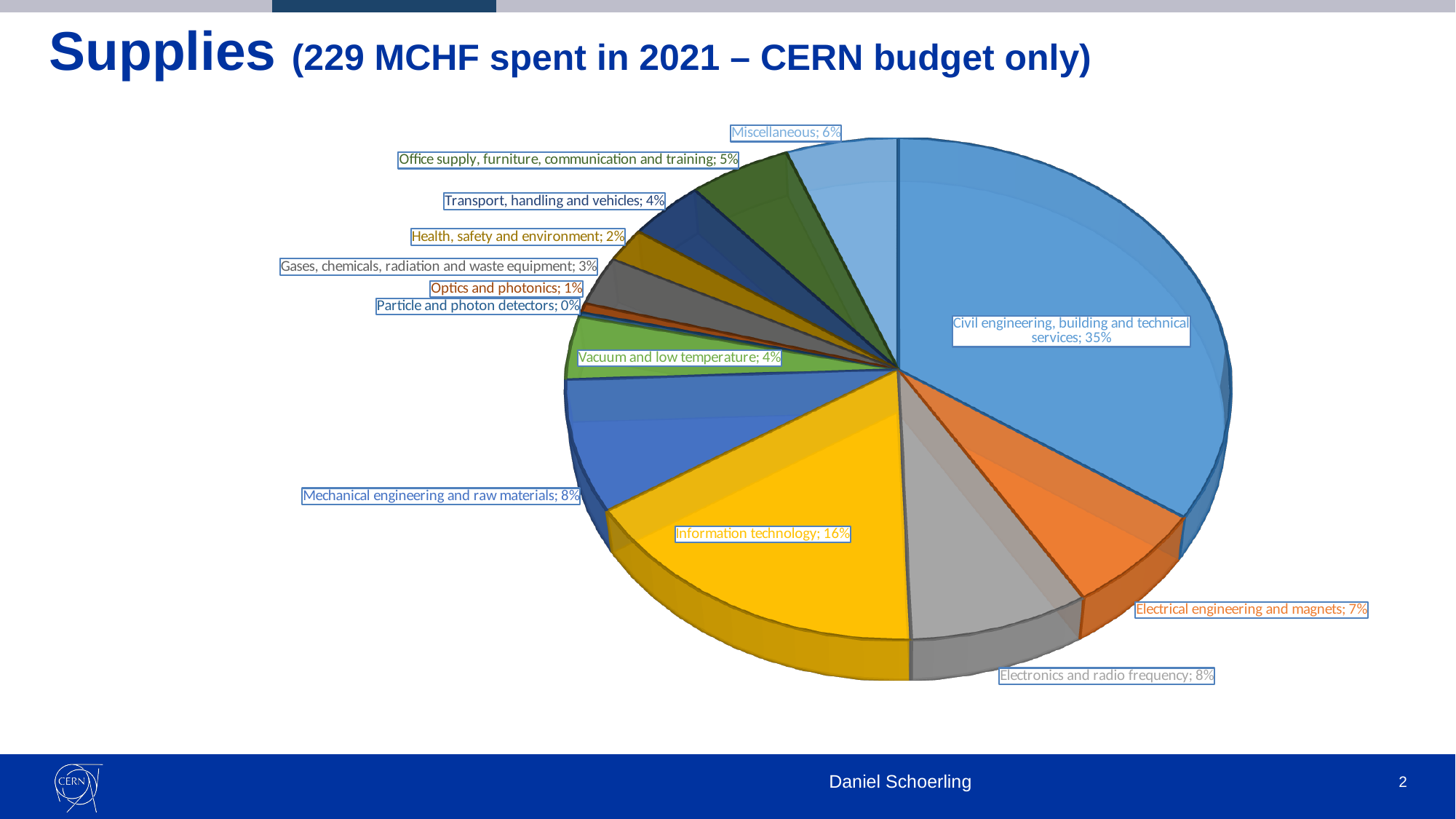
Which is larger, the share for Office supply, furniture, communication and training or the share for Transport, handling and vehicles? Office supply, furniture, communication and training What kind of chart is shown on the slide? pie chart What share of supplies spending goes to Information technology? 16% What percentage is shown for Electrical engineering and magnets? 7% How many categories are shown in the pie chart? 13 Which category has the smallest share of the pie? Particle and photon detectors What percentage is shown for Miscellaneous? 6% What percentage is shown for Gases, chemicals, radiation and waste equipment? 3% What share of supplies spending goes to Civil engineering, building and technical services? 35% What is the difference in percentage points between Civil engineering, building and technical services and Information technology? 19 Which category has the largest share of the pie? Civil engineering, building and technical services According to the slide title, how much was spent on supplies in 2021? 229 MCHF